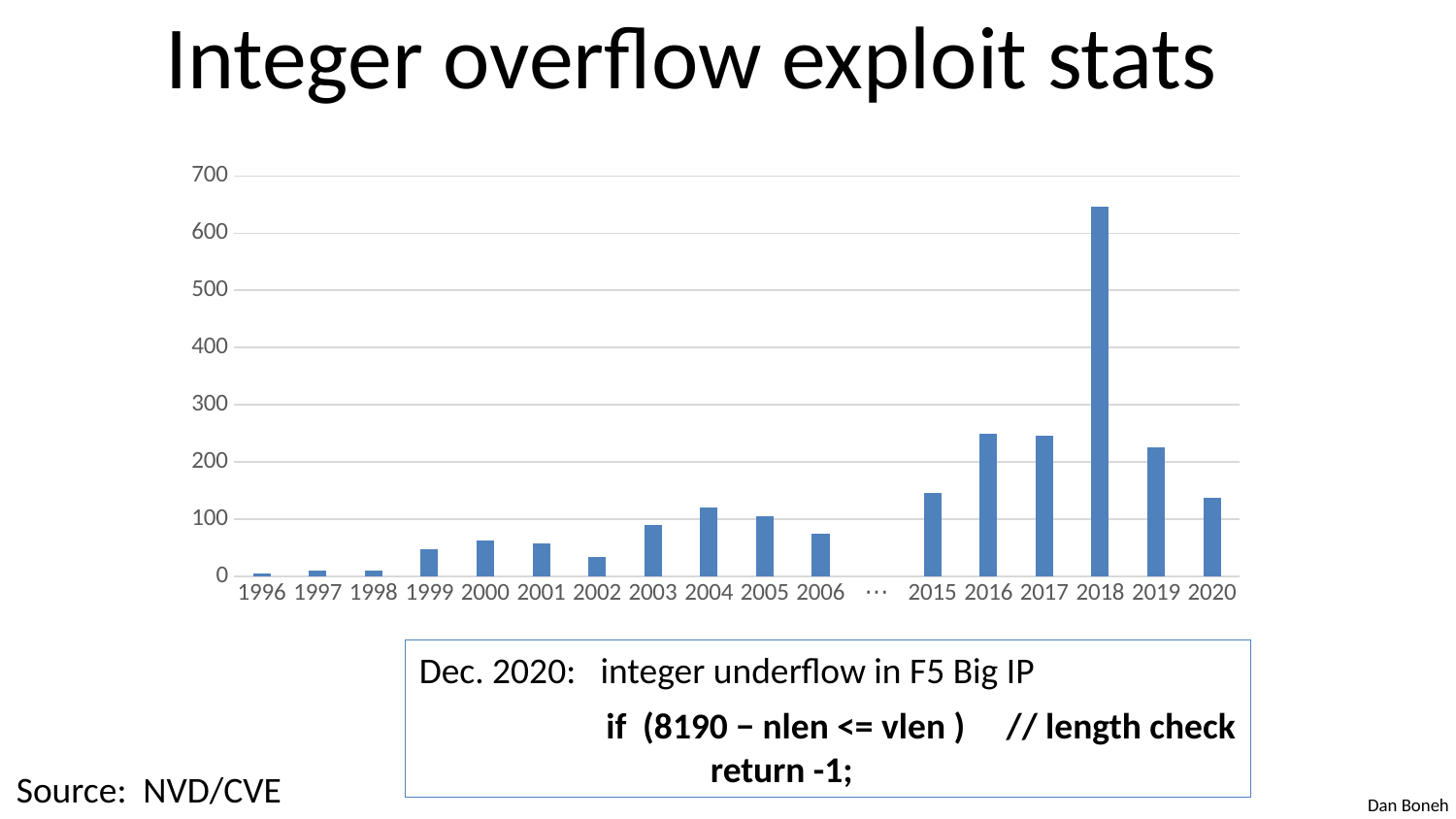
Do the values generally rise or fall from 2018 to 2020? fall Which year has the highest number of integer overflow exploits? 2018 Is the value for 2017 greater or less than 300? less Is the value for 2020 greater or less than 100? greater What source is cited for the chart data? NVD/CVE Which is larger, the value for 2019 or the value for 2020? 2019 Is the value for 2016 greater or less than 200? greater What kind of chart is shown on the slide? bar chart How many year labels appear on the x axis of the chart? 17 Which is larger, the value for 2004 or the value for 2002? 2004